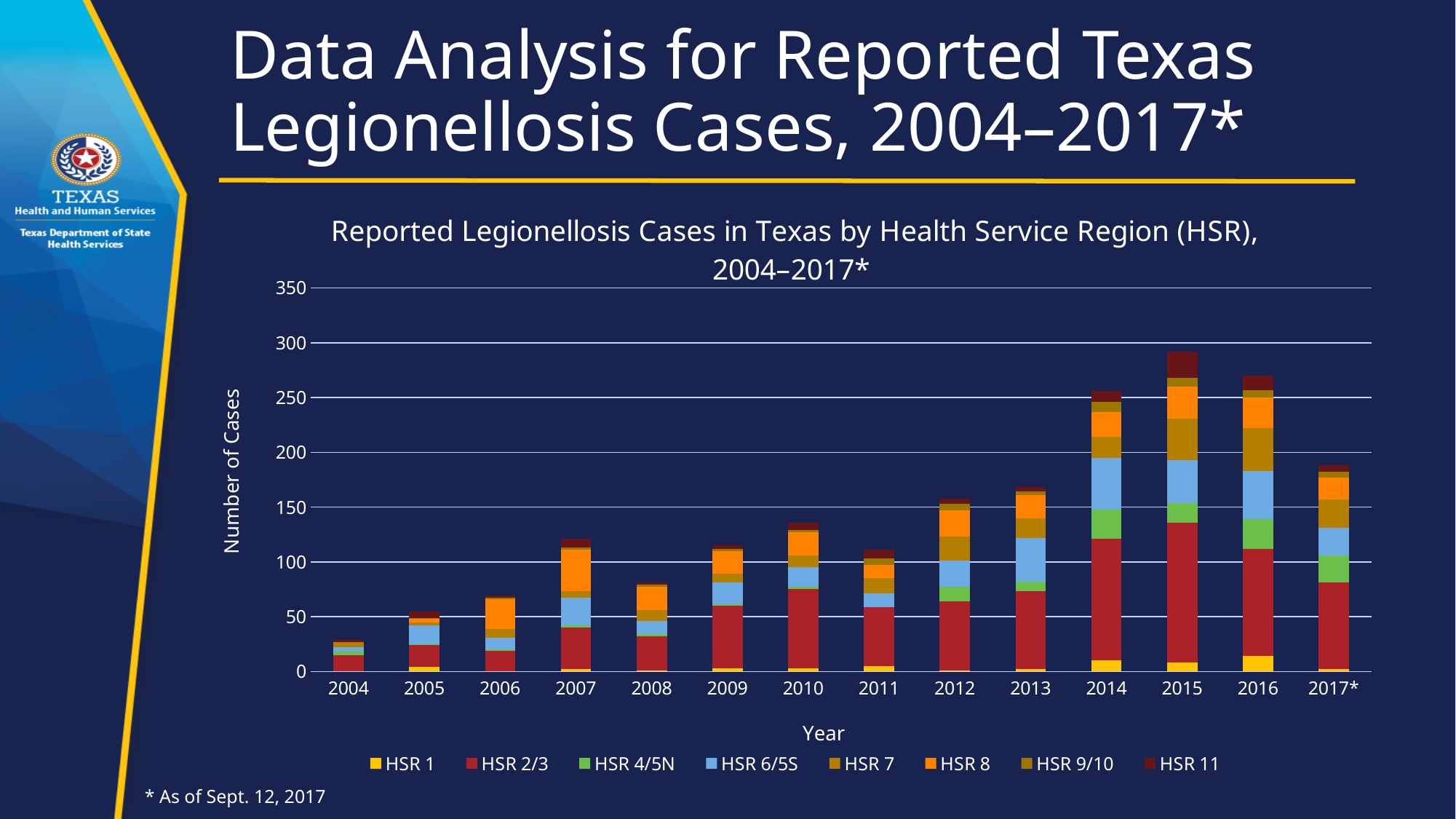
What is the label of the y axis of the chart? Number of Cases Which year has the highest total number of reported legionellosis cases? 2015 Is the total number of cases for 2017* greater or less than 200? less Is the total number of cases for 2004 greater or less than 50? less Which year has the lowest total number of reported legionellosis cases? 2004 What kind of chart is shown on the slide? Stacked bar chart Do the total reported cases generally rise or fall from 2004 to 2015? rise Is the total number of cases for 2014 greater or less than 200? greater How many series does the chart's legend list? 8 How many years are shown along the x axis of the chart? 14 Which year has a higher total number of cases, 2007 or 2008? 2007